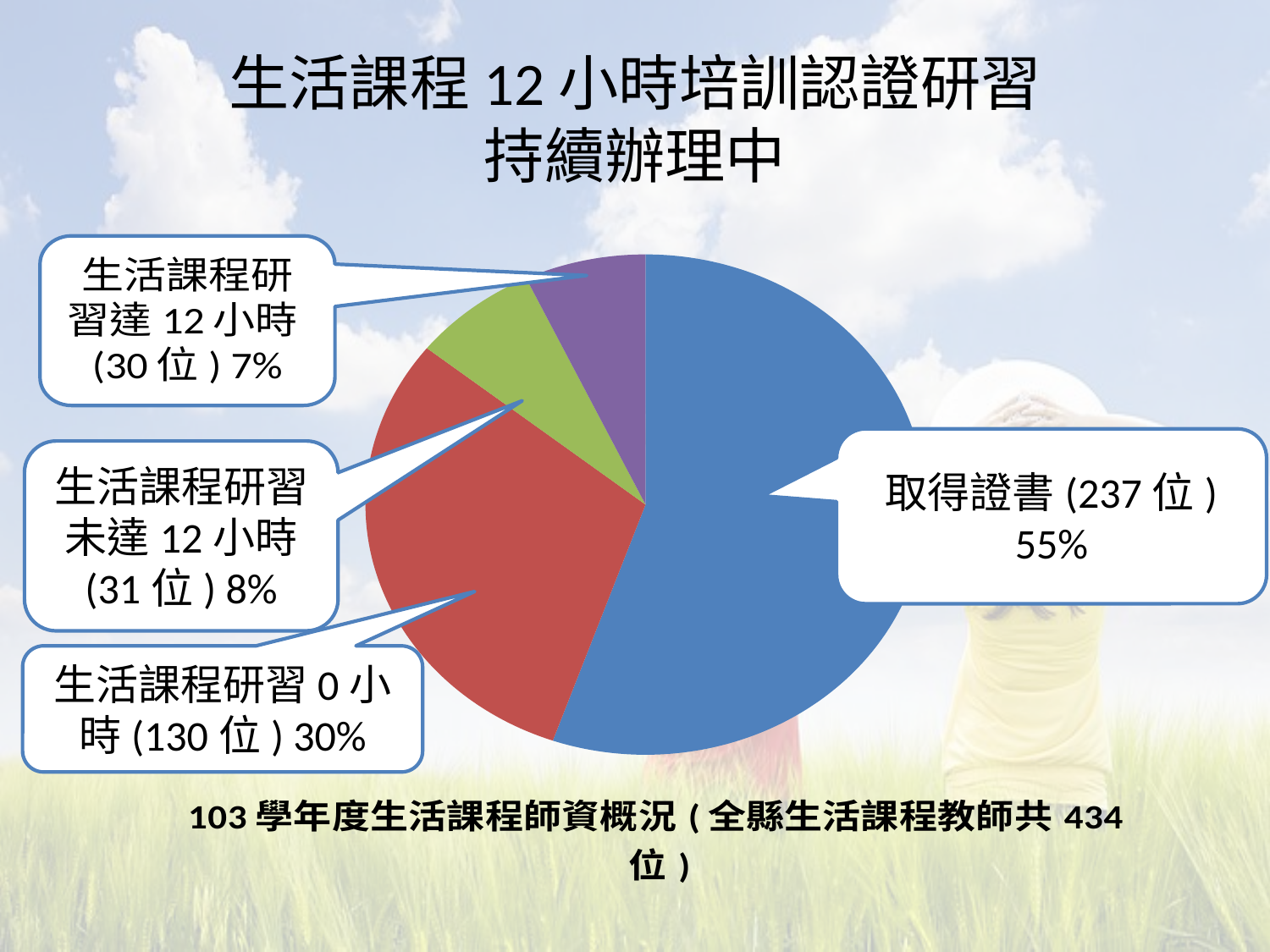
How many people are in the 生活課程研習達 12 小時 slice? 30 位 Which slice of the pie chart is the largest? 取得證書 How many people are in the 生活課程研習 0 小時 slice? 130 位 How many slices does the pie chart have? 4 What share of the pie does the 生活課程研習 0 小時 slice represent? 30% What is the difference in number of people between the 取得證書 slice and the 生活課程研習 0 小時 slice? 107 位 What share of the pie does the 取得證書 slice represent? 55% What colour is the 取得證書 slice in the pie chart? blue What kind of chart is shown on the slide? pie chart Which is larger, the 取得證書 slice or the 生活課程研習 0 小時 slice? 取得證書 How many people are in the 生活課程研習未達 12 小時 slice? 31 位 How many people are in the 取得證書 slice? 237 位